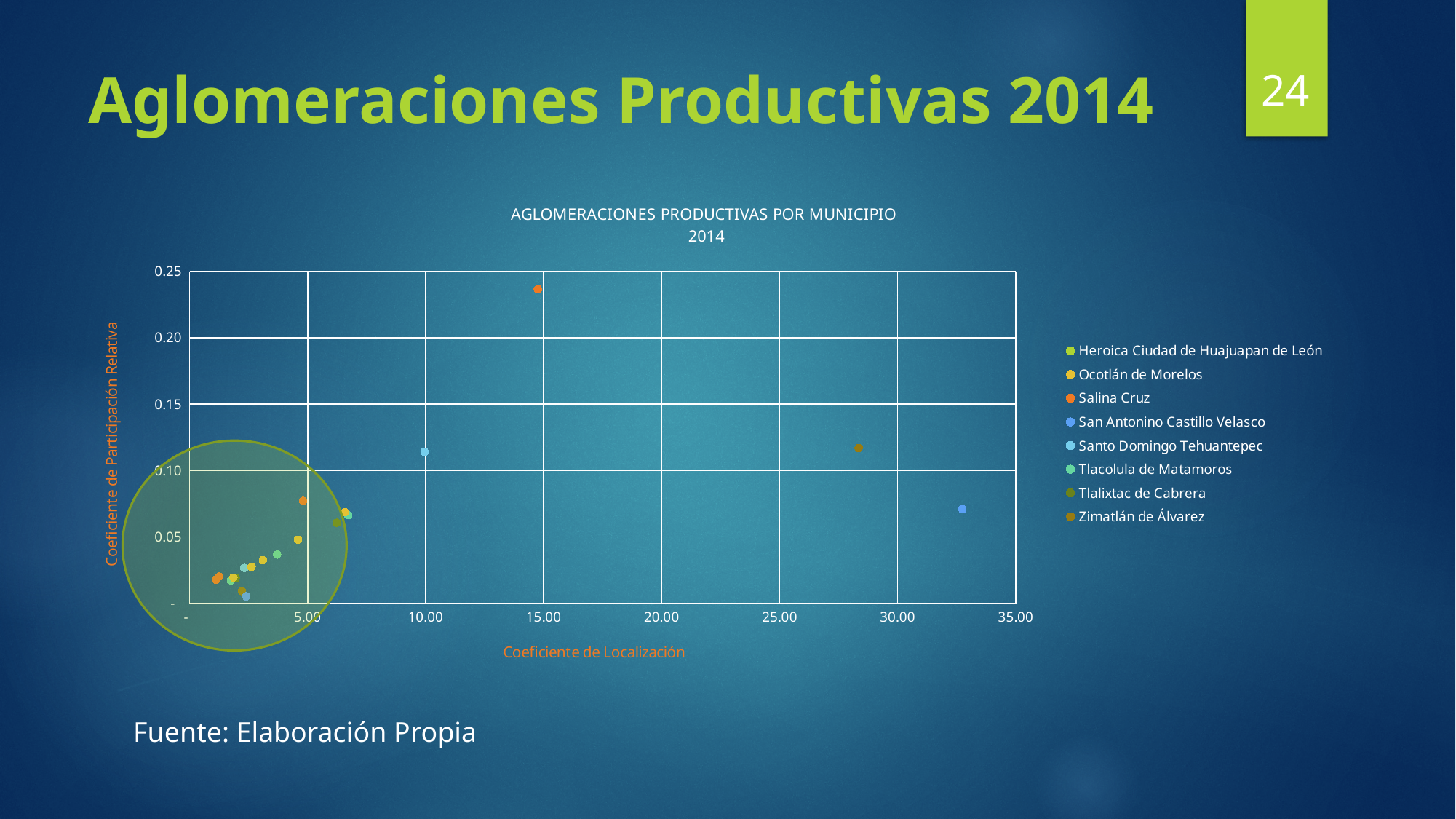
Is the Coeficiente de Localización of the rightmost point greater or less than 30.00? greater Is the Coeficiente de Participación Relativa of the Zimatlán de Álvarez point outside the cluster greater or less than 0.10? greater Which series has the point with the highest Coeficiente de Participación Relativa? Salina Cruz What kind of chart is shown on the slide? scatter chart What is the title of the chart? AGLOMERACIONES PRODUCTIVAS POR MUNICIPIO 2014 Is the Coeficiente de Participación Relativa of the topmost point greater or less than 0.20? greater What is the label of the horizontal axis of the chart? Coeficiente de Localización Which series has the point with the highest Coeficiente de Localización? San Antonino Castillo Velasco Which has a higher Coeficiente de Participación Relativa: the topmost Salina Cruz point or the rightmost San Antonino Castillo Velasco point? Salina Cruz How many series does the legend of the chart list? 8